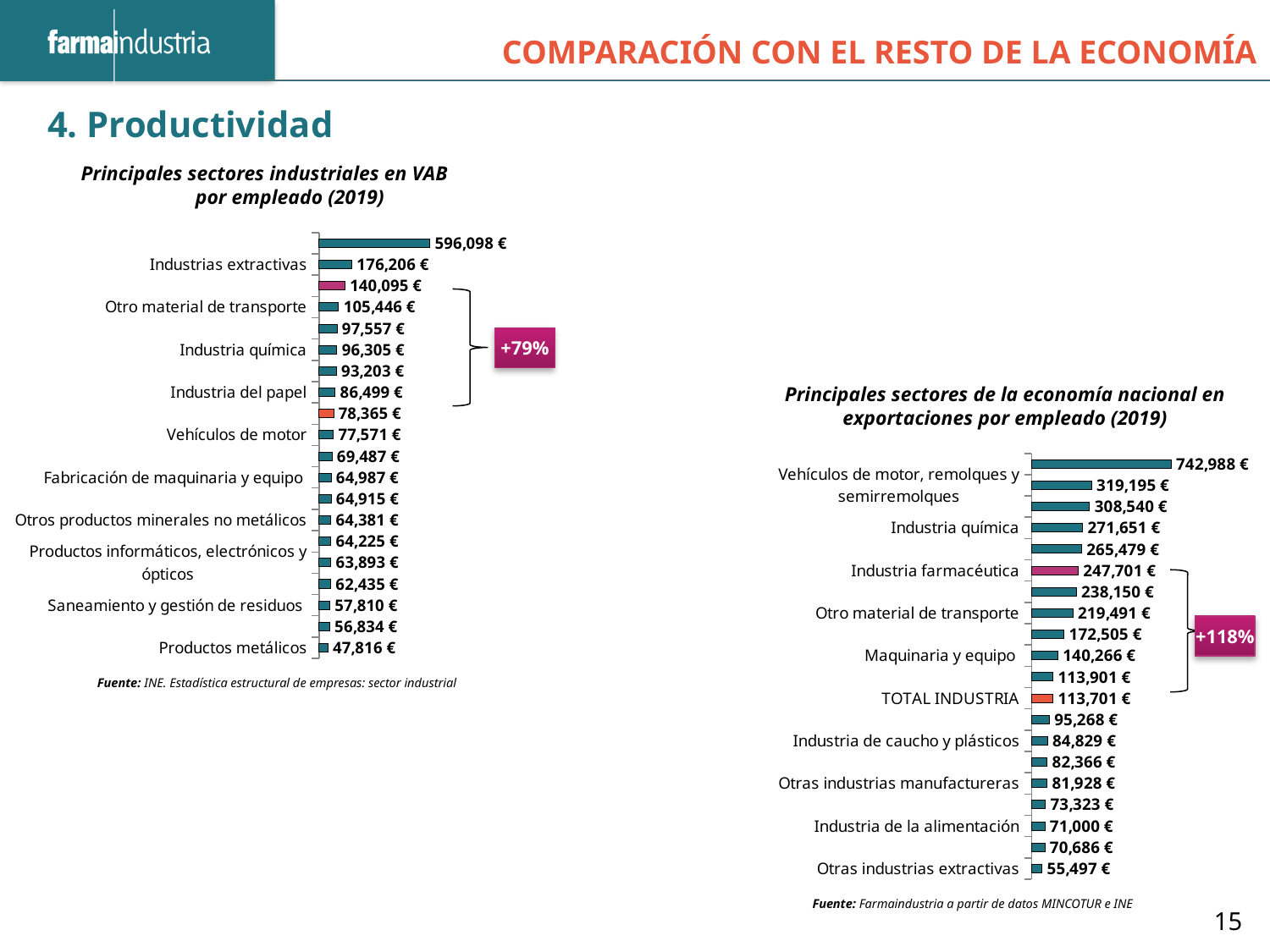
In the chart 'Principales sectores industriales en VAB por empleado (2019)', how many bars are plotted? 20 In the chart 'Principales sectores de la economía nacional en exportaciones por empleado (2019)', what is the difference between Industria farmacéutica and TOTAL INDUSTRIA? 134,000 € In the chart 'Principales sectores de la economía nacional en exportaciones por empleado (2019)', what is the value for Industria farmacéutica? 247,701 € In the chart 'Principales sectores industriales en VAB por empleado (2019)', which labelled category has the lowest value? Productos metálicos In the chart 'Principales sectores industriales en VAB por empleado (2019)', what is the value for Industrias extractivas? 176,206 € In the chart 'Principales sectores de la economía nacional en exportaciones por empleado (2019)', which is larger: Industria química or Otro material de transporte? Industria química In the chart 'Principales sectores industriales en VAB por empleado (2019)', what is the value for Productos metálicos? 47,816 € What type of chart is 'Principales sectores de la economía nacional en exportaciones por empleado (2019)'? Bar chart In the chart 'Principales sectores industriales en VAB por empleado (2019)', what is the difference between Industrias extractivas and Industria del papel? 89,707 € In the chart 'Principales sectores de la economía nacional en exportaciones por empleado (2019)', what is the value for TOTAL INDUSTRIA? 113,701 € In the chart 'Principales sectores industriales en VAB por empleado (2019)', what is the value for Industria química? 96,305 €